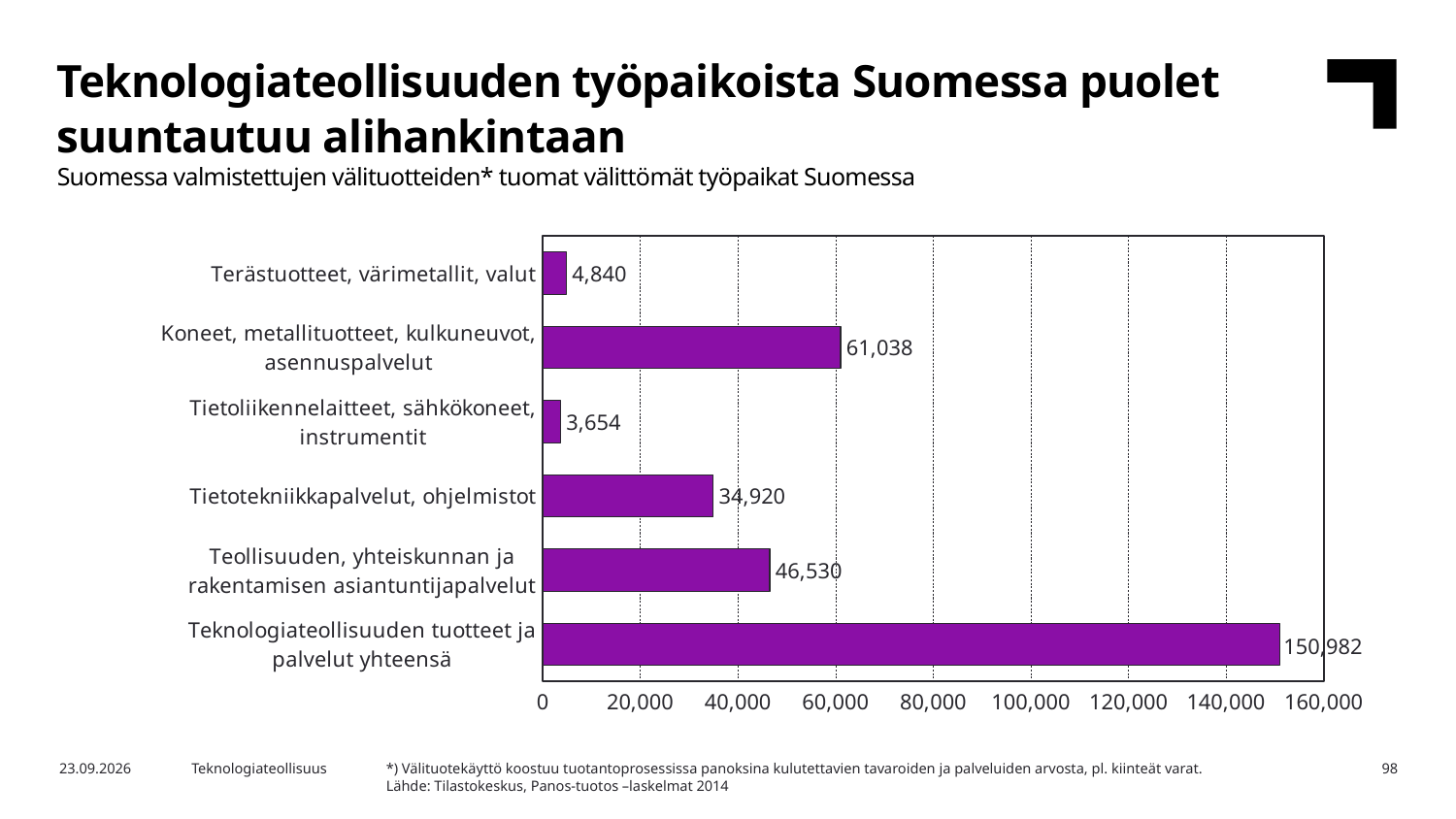
How many categories are shown in the chart? 6 What is the value for Teknologiateollisuuden tuotteet ja palvelut yhteensä? 150,982 What is the difference between Terästuotteet, värimetallit, valut and Tietoliikennelaitteet, sähkökoneet, instrumentit? 1,186 What is the value for Tietoliikennelaitteet, sähkökoneet, instrumentit? 3,654 Which is larger: Tietotekniikkapalvelut, ohjelmistot or Teollisuuden, yhteiskunnan ja rakentamisen asiantuntijapalvelut? Teollisuuden, yhteiskunnan ja rakentamisen asiantuntijapalvelut What is the value for Koneet, metallituotteet, kulkuneuvot, asennuspalvelut? 61,038 What is the value for Tietotekniikkapalvelut, ohjelmistot? 34,920 Which category has the lowest value? Tietoliikennelaitteet, sähkökoneet, instrumentit Which category has the highest value? Teknologiateollisuuden tuotteet ja palvelut yhteensä What is the difference between Koneet, metallituotteet, kulkuneuvot, asennuspalvelut and Teollisuuden, yhteiskunnan ja rakentamisen asiantuntijapalvelut? 14,508 What kind of chart is shown on the slide? Bar chart Is the value for Koneet, metallituotteet, kulkuneuvot, asennuspalvelut greater or less than 60,000? greater